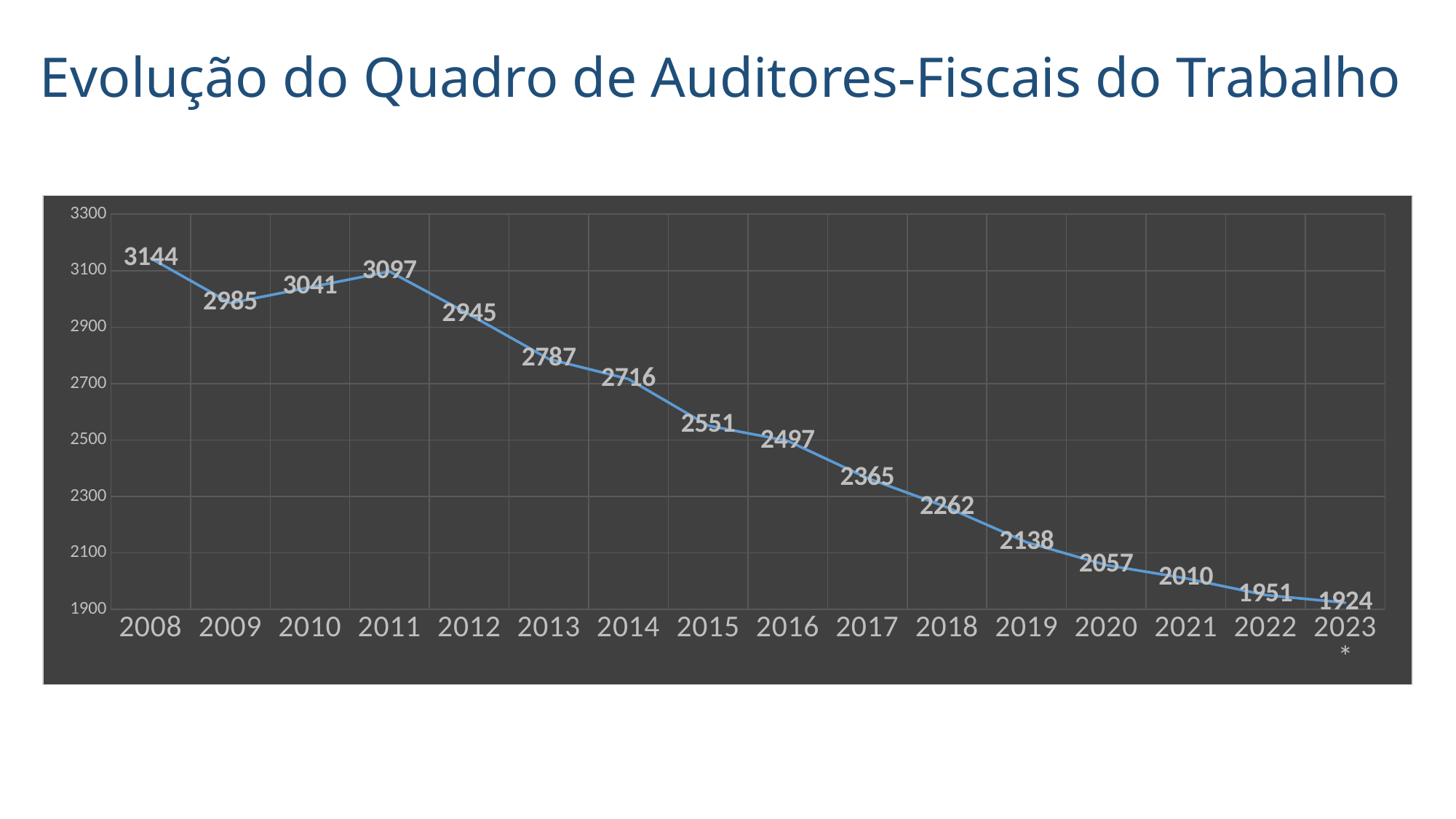
Which year has the highest value? 2008 What is the difference between the values for 2011 and 2012? 152 What is the value for 2015? 2551 Is the value for 2014 greater or less than 2700? greater What kind of chart is shown on the slide? line chart How many years are plotted on the x axis? 16 Do the values generally rise or fall from 2011 to 2023*? fall Which is larger, the value for 2010 or the value for 2011? 2011 What is the value for 2023*? 1924 Which year has the lowest value? 2023* What is the difference between the values for 2008 and 2023*? 1220 What is the value for 2008? 3144